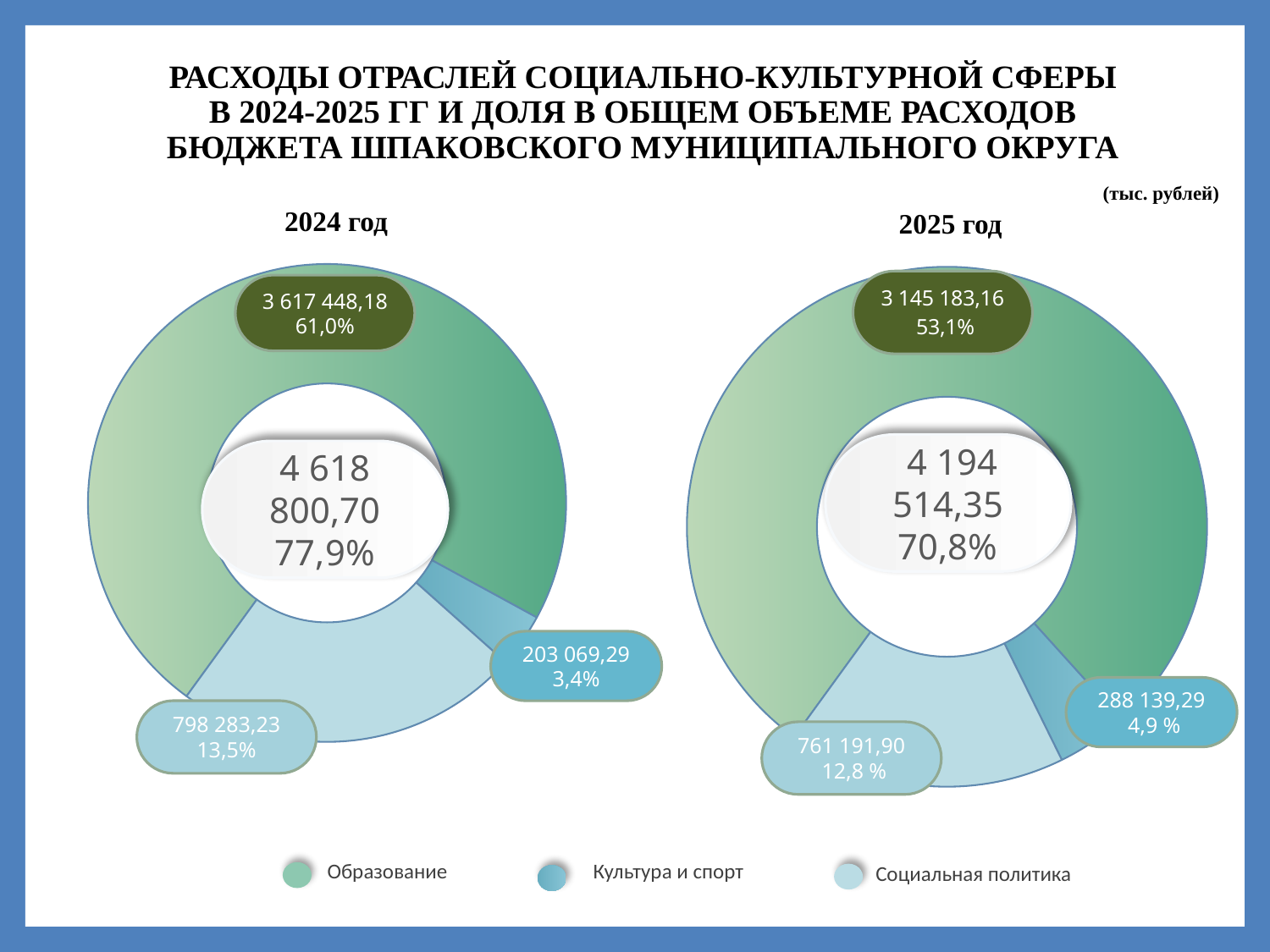
On the 2025 год chart, what percentage is shown for Образование? 53,1% What unit is stated for the values on the slide? тыс. рублей On the 2024 год chart, which category has the largest value? Образование What kind of chart is used for 2024 год? Donut (pie) chart What percentage is shown in the centre of the 2025 год chart? 70,8% On the 2024 год chart, what percentage is shown for Культура и спорт? 3,4% On the 2024 год chart, what is the value shown for Образование? 3 617 448,18 On the 2025 год chart, which category has the smallest value? Культура и спорт On the 2025 год chart, which is larger: Социальная политика or Культура и спорт? Социальная политика On the 2025 год chart, what is the value shown for Социальная политика? 761 191,90 What total value is shown in the centre of the 2024 год chart? 4 618 800,70 How many categories does the legend list? 3